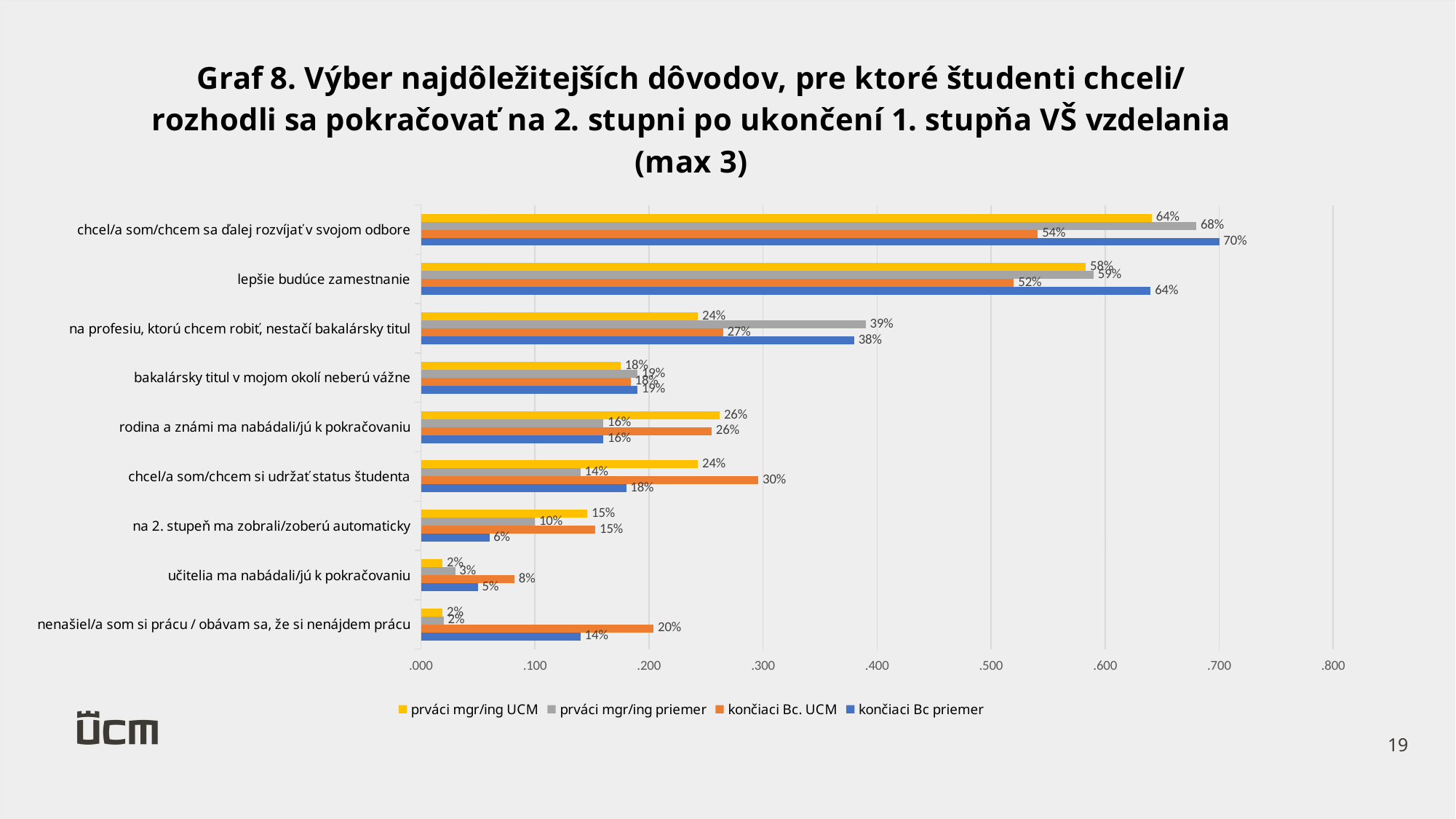
Which category has the highest value for 'končiaci Bc priemer'? chcel/a som/chcem sa ďalej rozvíjať v svojom odbore What kind of chart is shown on the slide? bar chart What is the value for 'končiaci Bc priemer' for 'chcel/a som/chcem sa ďalej rozvíjať v svojom odbore'? 70% What is the value for 'prváci mgr/ing priemer' for 'na profesiu, ktorú chcem robiť, nestačí bakalársky titul'? 39% What is the value for 'končiaci Bc. UCM' for 'chcel/a som/chcem si udržať status študenta'? 30% How many series does the legend list? 4 For 'lepšie budúce zamestnanie', which is larger: 'končiaci Bc priemer' or 'končiaci Bc. UCM'? končiaci Bc priemer Is the value for 'prváci mgr/ing priemer' for 'chcel/a som/chcem sa ďalej rozvíjať v svojom odbore' greater or less than .600? greater Which series is shown in orange in the legend? končiaci Bc. UCM Which category has the lowest value for 'končiaci Bc priemer'? učitelia ma nabádali/jú k pokračovaniu What is the difference between 'končiaci Bc. UCM' and 'prváci mgr/ing UCM' for 'nenašiel/a som si prácu / obávam sa, že si nenájdem prácu'? 18% How many categories (reasons) are shown on the chart? 9